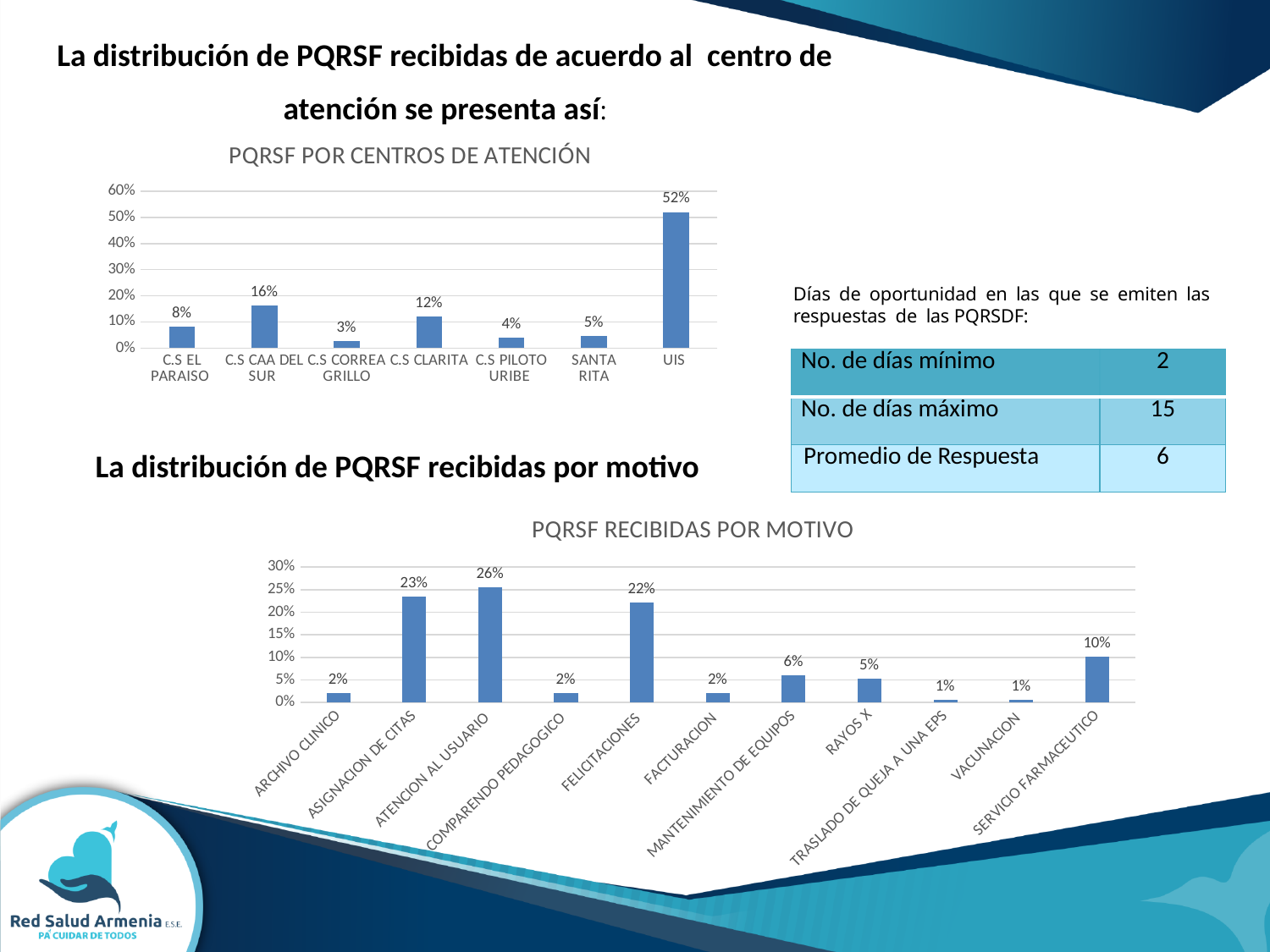
In the chart titled PQRSF RECIBIDAS POR MOTIVO, what is the value for SERVICIO FARMACEUTICO? 10% In the chart titled PQRSF RECIBIDAS POR MOTIVO, which motive has the highest value? ATENCION AL USUARIO In the chart titled PQRSF POR CENTROS DE ATENCIÓN, which centre has the highest value? UIS In the chart titled PQRSF POR CENTROS DE ATENCIÓN, how many centres are shown? 7 In the chart titled PQRSF POR CENTROS DE ATENCIÓN, what is the difference between C.S CAA DEL SUR and C.S CLARITA? 4% In the chart titled PQRSF POR CENTROS DE ATENCIÓN, what is the value for UIS? 52% What type of chart is PQRSF RECIBIDAS POR MOTIVO? Bar chart In the chart titled PQRSF RECIBIDAS POR MOTIVO, what is the difference between ASIGNACION DE CITAS and MANTENIMIENTO DE EQUIPOS? 17% In the chart titled PQRSF RECIBIDAS POR MOTIVO, what is the value for FELICITACIONES? 22% In the chart titled PQRSF POR CENTROS DE ATENCIÓN, which centre has the lowest value? C.S CORREA GRILLO In the chart titled PQRSF RECIBIDAS POR MOTIVO, how many motives are shown? 11 In the chart titled PQRSF POR CENTROS DE ATENCIÓN, which is larger, C.S EL PARAISO or SANTA RITA? C.S EL PARAISO